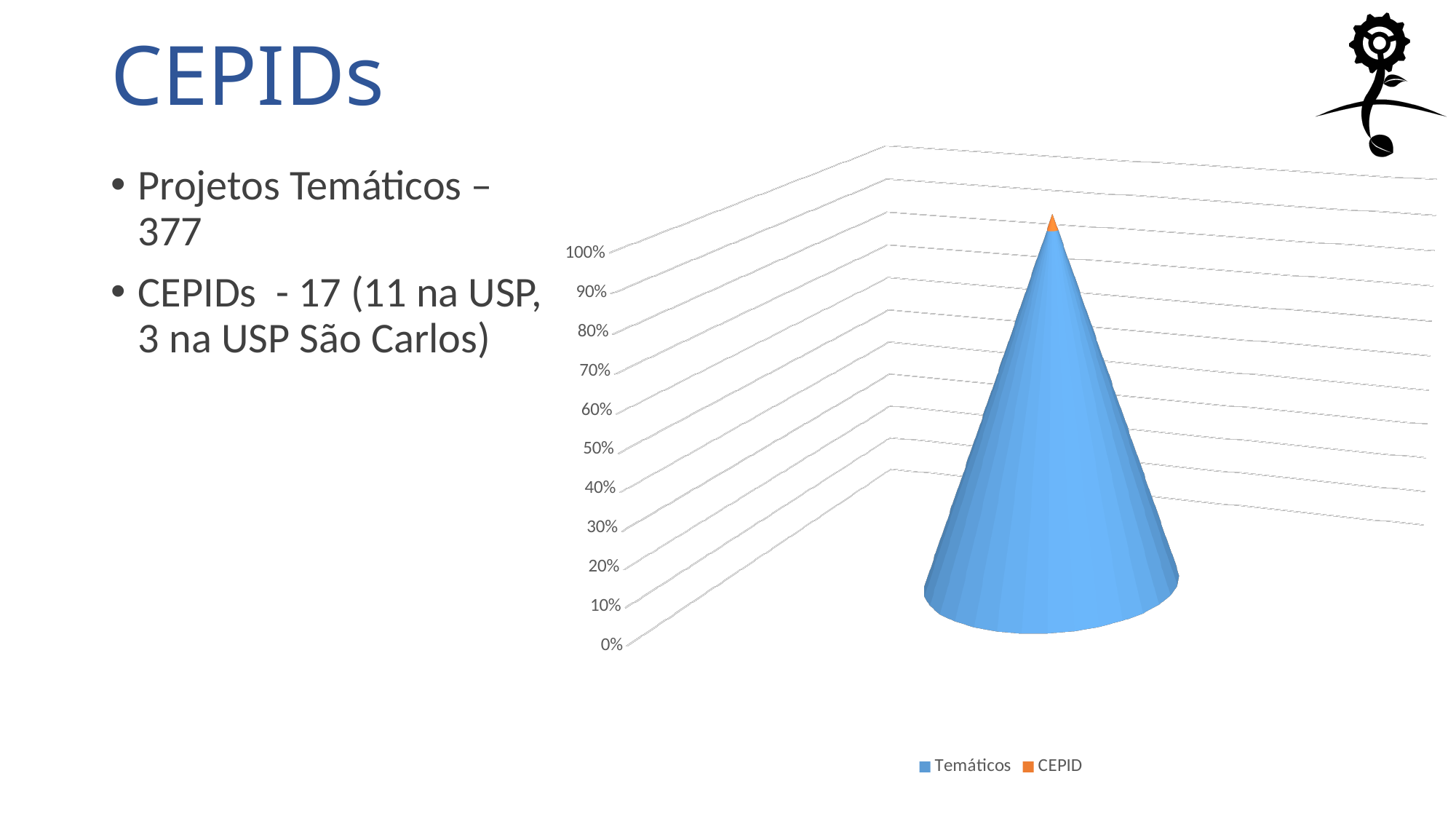
How many series does the chart legend list? 2 Which series is shown in blue in the chart? Temáticos Which series takes up the smaller share of the stacked bar? CEPID Which series takes up the larger share of the stacked bar, Temáticos or CEPID? Temáticos How many stacked bars are plotted in the chart? 1 What are the two series named in the chart legend? Temáticos and CEPID Is the share for CEPID greater or less than 10%? less Is the share for Temáticos greater or less than 50%? greater Is the share for Temáticos greater or less than 90%? greater What is the highest value shown on the chart's vertical axis? 100% What kind of chart is shown on the slide? Stacked bar chart (3D cone)